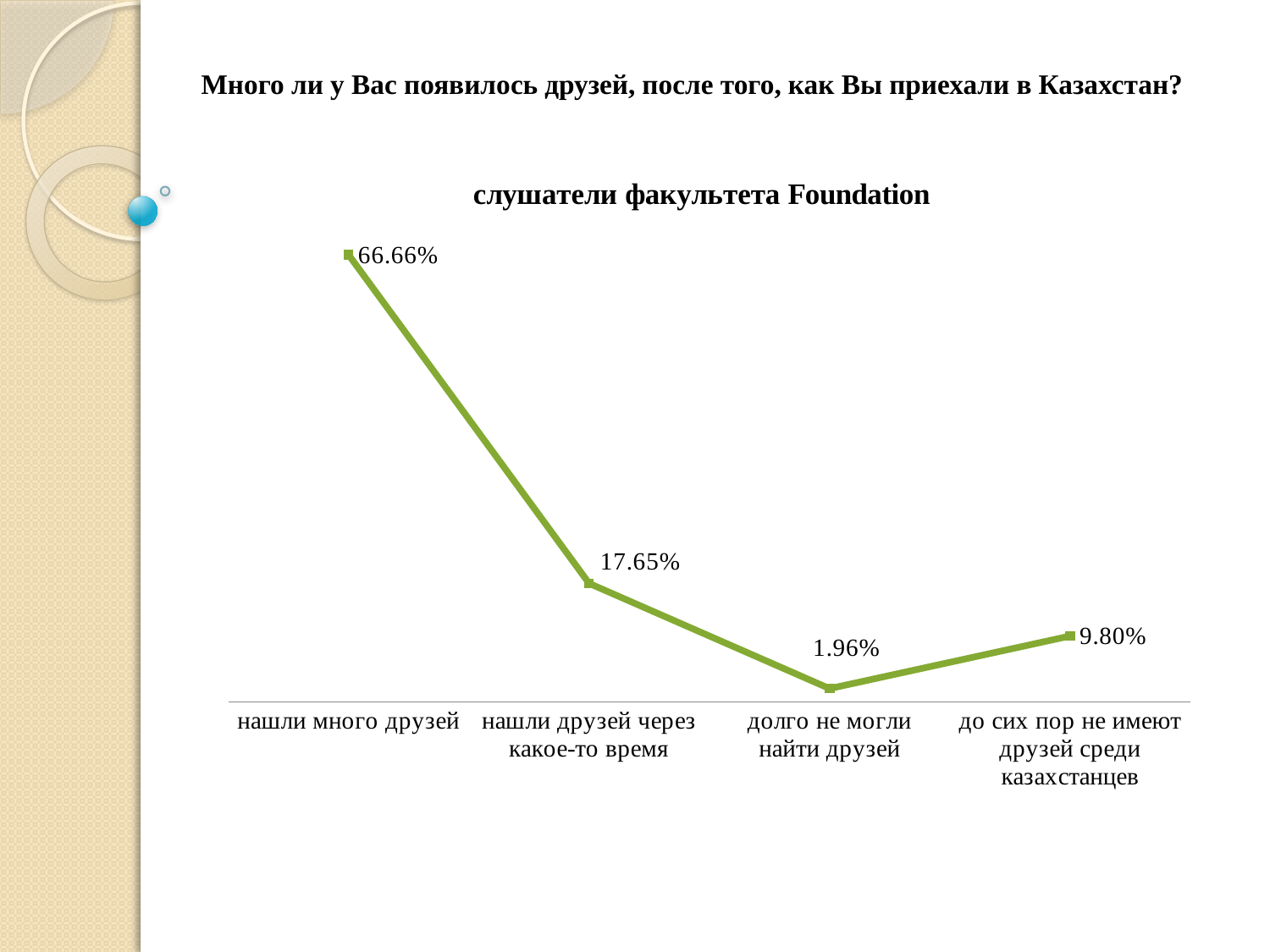
What is the value for "до сих пор не имеют друзей среди казахстанцев"? 9.80% Which is larger: the value for "нашли друзей через какое-то время" or the value for "до сих пор не имеют друзей среди казахстанцев"? нашли друзей через какое-то время Which category has the highest value? нашли много друзей What is the value for "нашли друзей через какое-то время"? 17.65% What is the difference between the values for "нашли много друзей" and "нашли друзей через какое-то время"? 49.01% What is the value for "долго не могли найти друзей"? 1.96% Which category has the lowest value? долго не могли найти друзей What kind of chart is shown on the slide? line chart What is the difference between the values for "до сих пор не имеют друзей среди казахстанцев" and "долго не могли найти друзей"? 7.84% How many categories are plotted on the chart? 4 What is the value for "нашли много друзей"? 66.66% What is the title of the chart? слушатели факультета Foundation